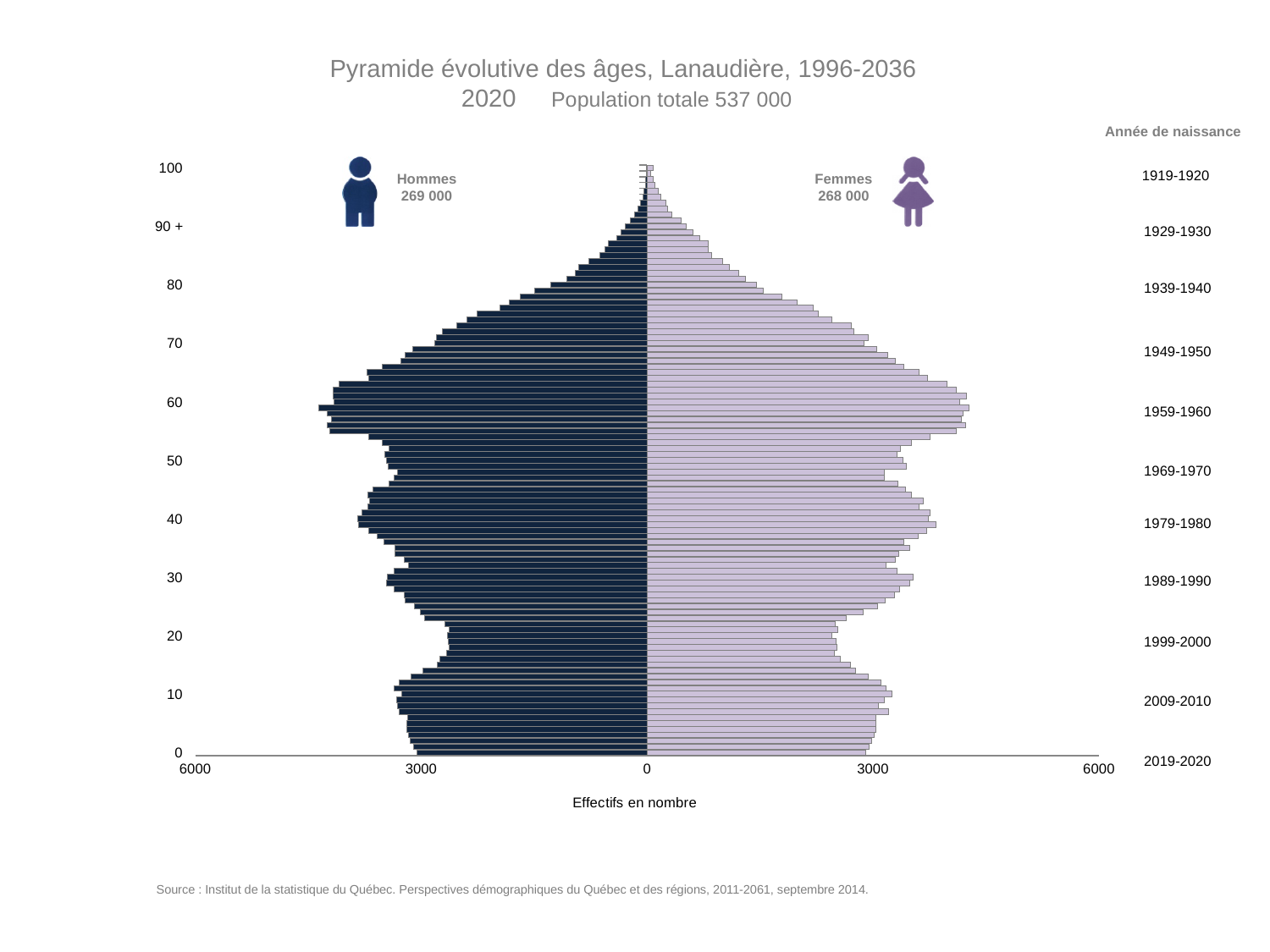
Which group is larger, Hommes or Femmes? Hommes What is the number of Hommes (men) shown on the chart? 269 000 What is the number of Femmes (women) shown on the chart? 268 000 Is the value for Hommes at age 90 + greater or less than 3000? less What is the total population shown for Lanaudière in 2020? 537 000 Is the value for Femmes at age 20 greater or less than 3000? less Which year does the pyramid on the slide show? 2020 What is the label of the horizontal axis? Effectifs en nombre Is the value for Hommes at age 60 greater or less than 3000? greater From age 60 up to age 100, do the bars for Hommes rise or fall? fall What is the difference between the number of Hommes and the number of Femmes? 1 000 What kind of chart is shown on the slide? bar chart